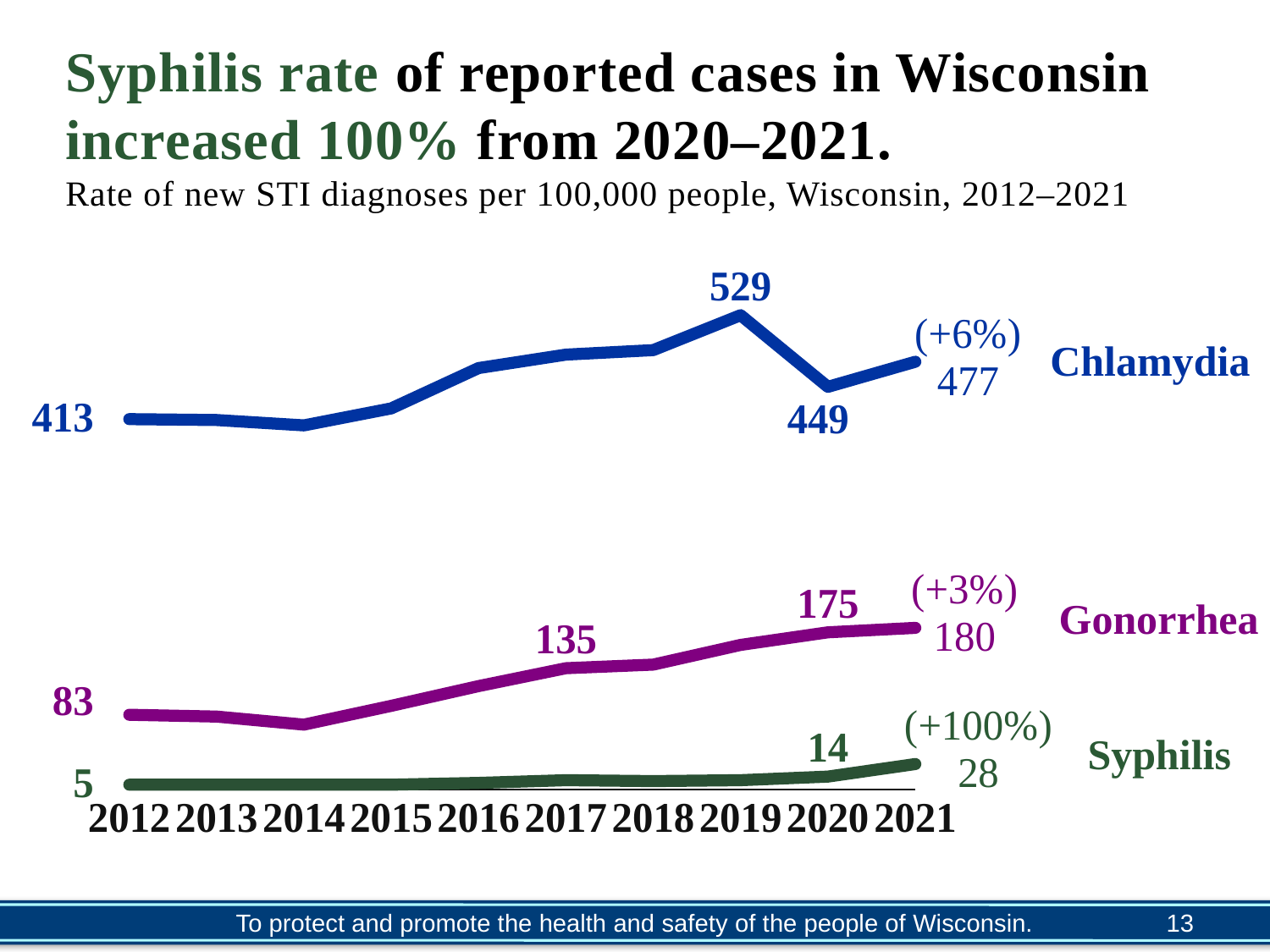
Which series has the lowest rate in 2012? Syphilis What is the difference between the Chlamydia rate in 2019 and in 2020? 80 How many series are plotted on the chart? 3 What was the Gonorrhea rate in 2012? 83 What was the Chlamydia rate in 2021? 477 Which is larger, the Gonorrhea rate in 2021 or the Gonorrhea rate in 2017? Gonorrhea rate in 2021 What kind of chart is shown on the slide? line chart Which series has the highest rate in 2021? Chlamydia What was the Chlamydia rate in 2019? 529 What was the Syphilis rate in 2020? 14 Does the Syphilis rate rise or fall from 2012 to 2021? rise How many years are shown on the x axis? 10